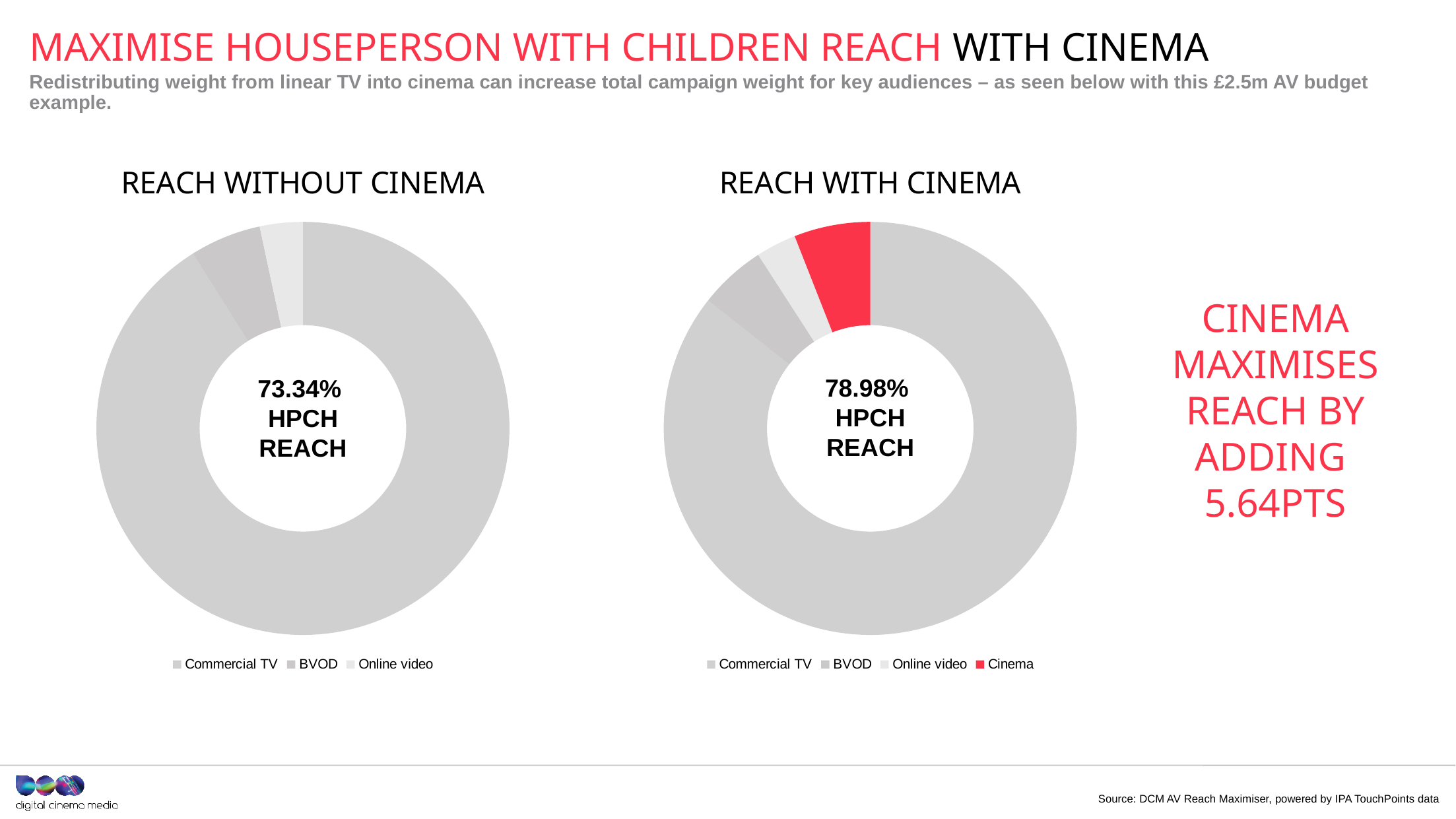
In the 'REACH WITHOUT CINEMA' chart, which category has the largest slice? Commercial TV In the 'REACH WITH CINEMA' chart, which legend entry is shown in red? Cinema In the 'REACH WITH CINEMA' chart, which category has the largest slice? Commercial TV In the 'REACH WITH CINEMA' chart, which slice is larger, Commercial TV or BVOD? Commercial TV Which chart shows the higher HPCH reach, 'REACH WITHOUT CINEMA' or 'REACH WITH CINEMA'? REACH WITH CINEMA In the 'REACH WITHOUT CINEMA' chart, which category has the smallest slice? Online video In the 'REACH WITHOUT CINEMA' chart, what HPCH reach value is shown in the centre? 73.34% How many series does the legend of the 'REACH WITH CINEMA' chart list? 4 What type of chart is used for 'REACH WITHOUT CINEMA'? Pie chart (donut) In the 'REACH WITH CINEMA' chart, what HPCH reach value is shown in the centre? 78.98% How many series does the legend of the 'REACH WITHOUT CINEMA' chart list? 3 What is the difference in HPCH reach between the 'REACH WITH CINEMA' chart and the 'REACH WITHOUT CINEMA' chart? 5.64 points